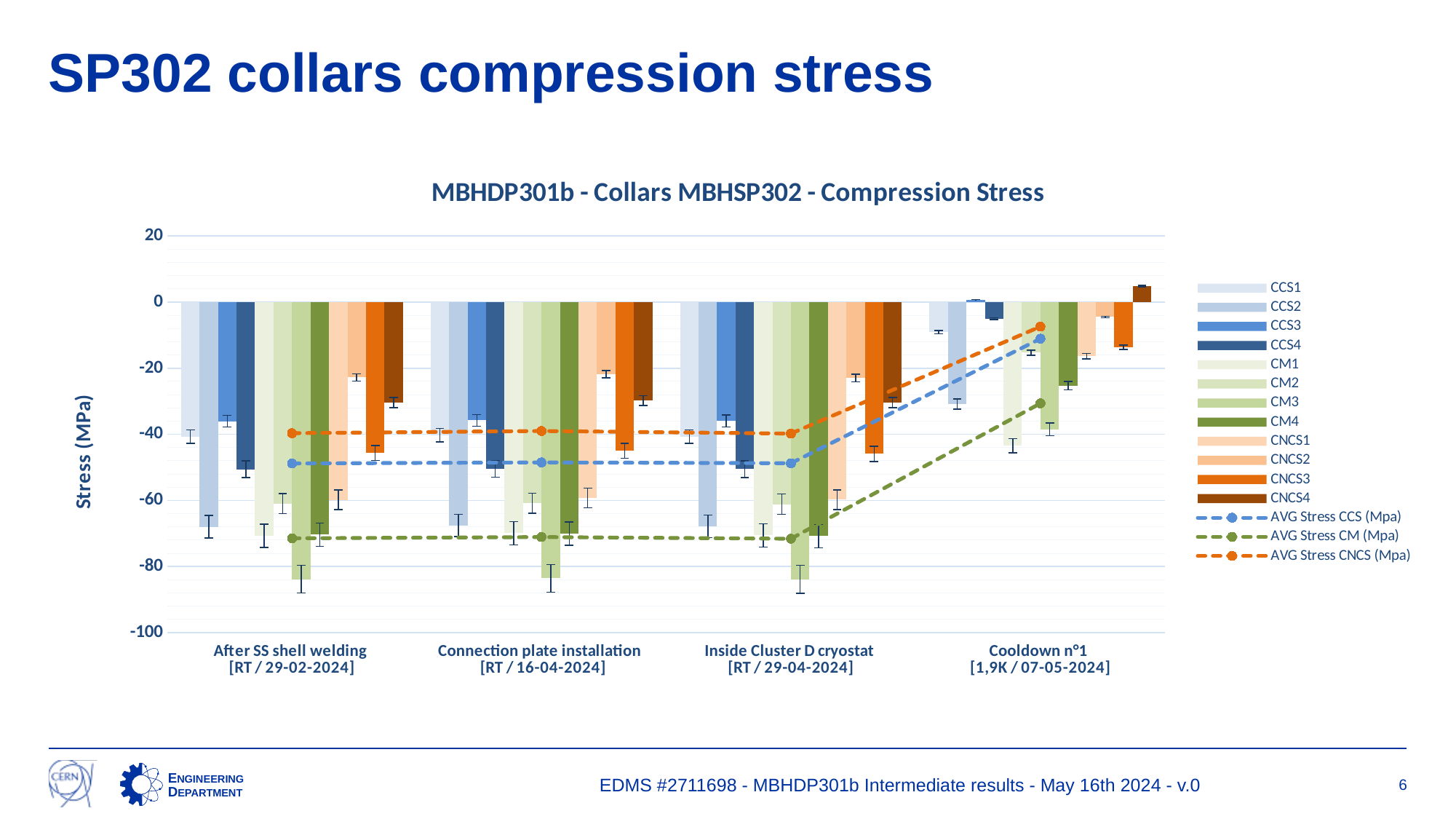
At 'Cooldown n°1', which series has the highest value? CNCS4 What is the title of the chart? MBHDP301b - Collars MBHSP302 - Compression Stress Is the value for CCS4 at 'Cooldown n°1' greater or less than -20? greater Is the AVG Stress CM value at 'After SS shell welding' greater or less than -60? less Does the AVG Stress CCS line rise or fall from 'Inside Cluster D cryostat' to 'Cooldown n°1'? rises How many series does the legend list? 15 Is the value for CM3 at 'After SS shell welding' greater or less than -80? less At 'After SS shell welding', which series has the lowest (most negative) value? CM3 How many categories are shown along the x axis? 4 What is the label of the vertical axis? Stress (MPa) What kind of chart is this? Bar chart with dashed line series